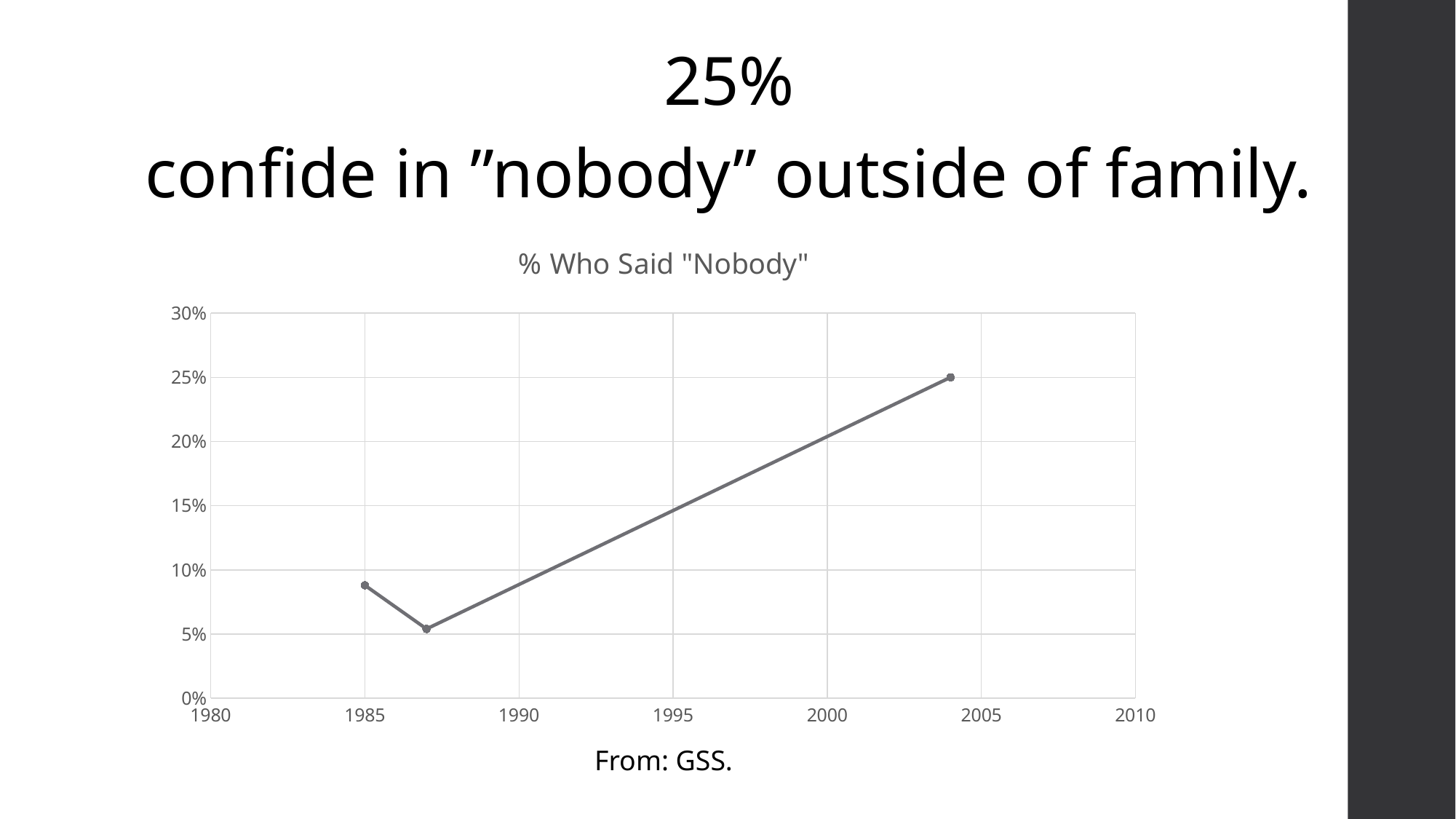
What is the title of the chart? % Who Said "Nobody" Which data point has the highest value: the first, the middle, or the last? the last How many data points are plotted on the line? 3 Does the line rise or fall between the middle data point and the last data point? rise Is the value of the data point at 1985 greater or less than 10%? less Is the value at 1985 larger or smaller than the value of the last data point? smaller What is the highest value shown on the y axis? 30% Which data point has the lowest value: the first, the middle, or the last? the middle Is the value of the middle data point greater or less than 10%? less What is the value of the rightmost (latest) data point on the line? 25% Is the value of the rightmost data point greater or less than 20%? greater What kind of chart is shown on the slide? line chart